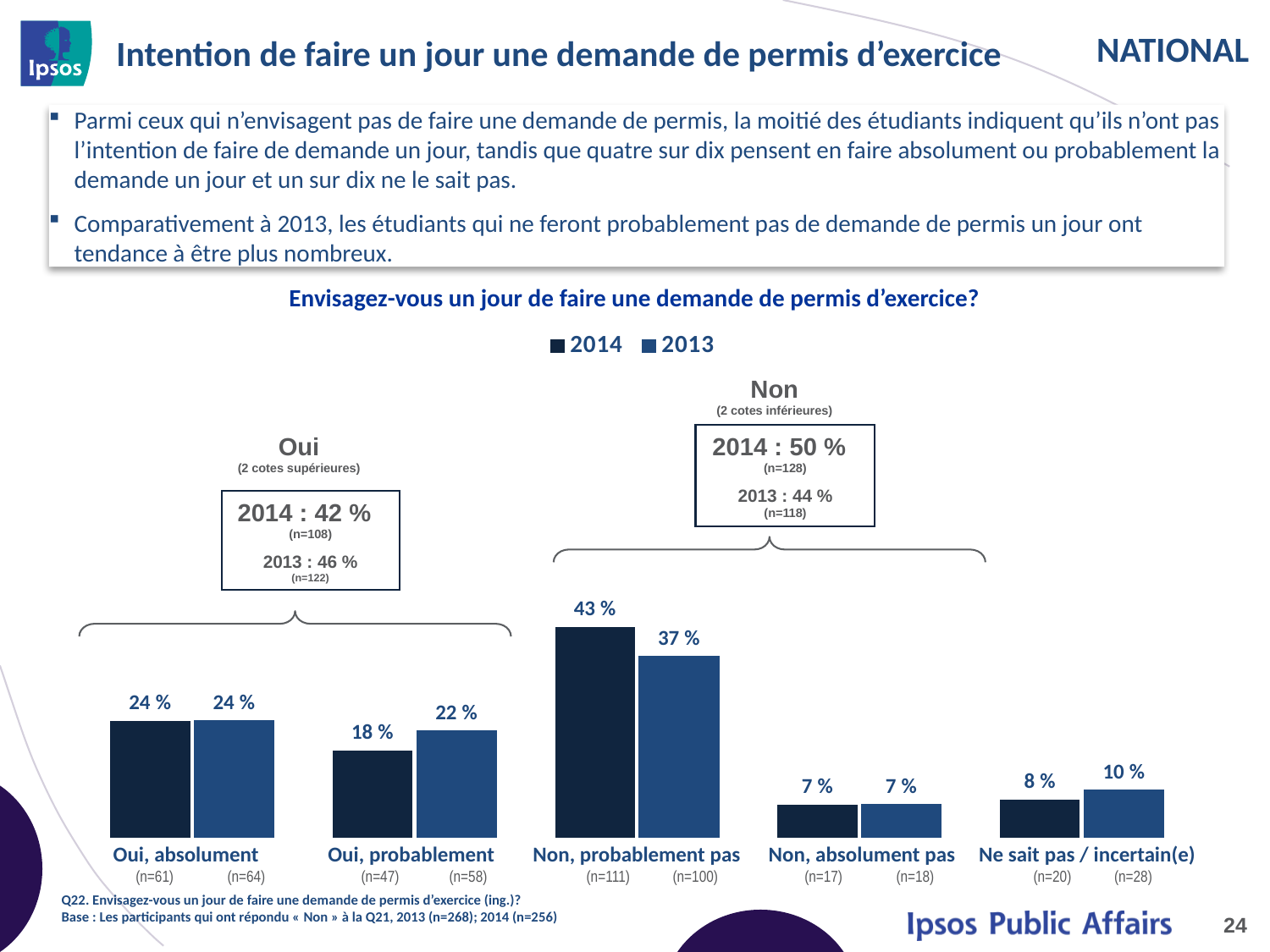
For "Ne sait pas / incertain(e)", which year has the larger value, 2014 or 2013? 2013 What kind of chart is shown on the slide? Bar chart How many categories are shown on the x axis of the chart? 5 How many series does the legend list? 2 What is the difference between the 2014 and 2013 values for "Non, probablement pas"? 6 % What is the difference between the 2013 and 2014 values for "Oui, probablement"? 4 % Which category has the highest 2014 value? Non, probablement pas What is the 2013 value for "Oui, probablement"? 22 % Which series is shown in the darker navy colour in the legend? 2014 Which category has the lowest 2013 value? Non, absolument pas What is the 2014 value for "Non, probablement pas"? 43 % What is the 2013 value for "Ne sait pas / incertain(e)"? 10 %